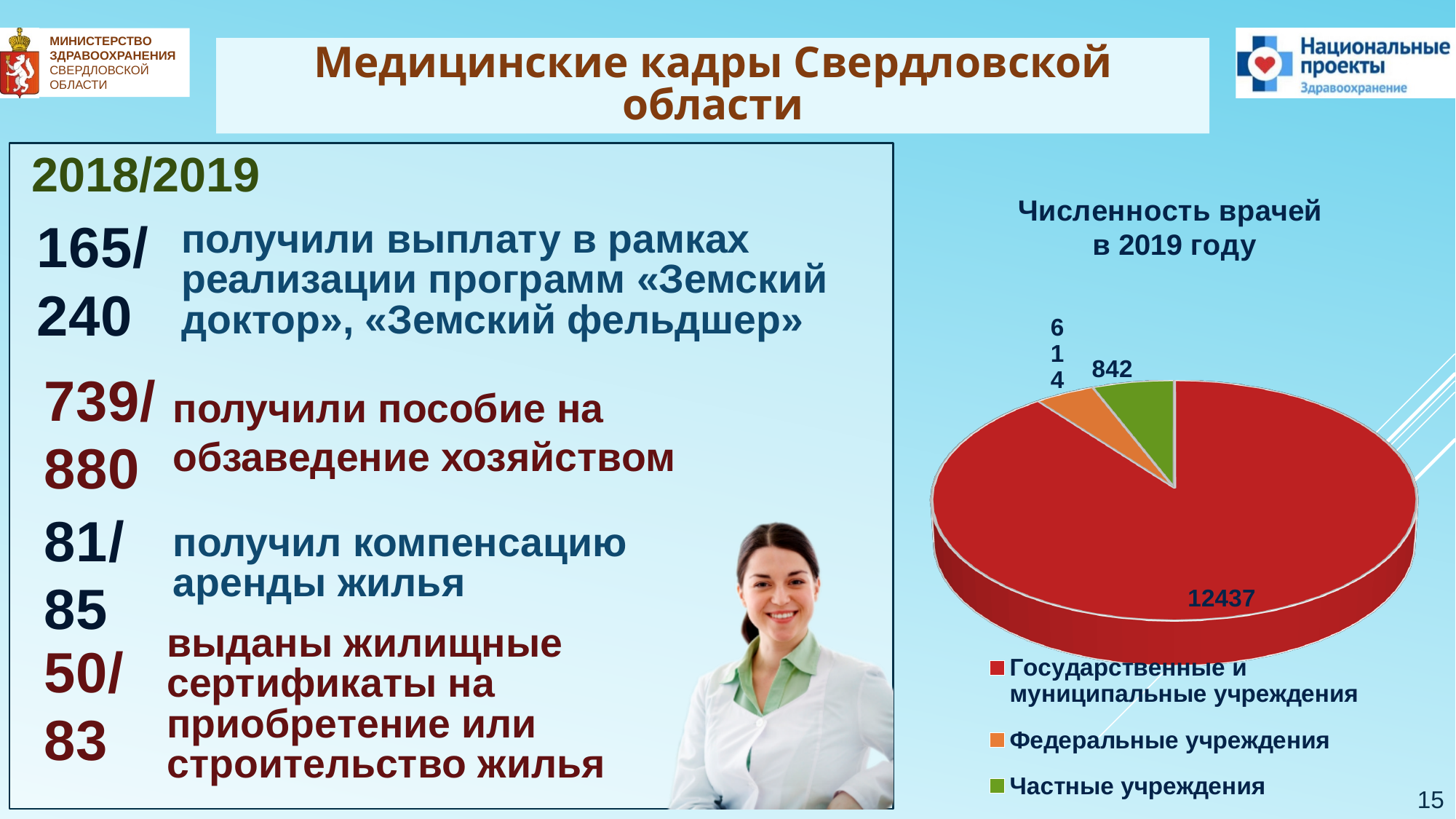
What type of chart is shown on the slide? pie chart How many slices does the pie chart have? 3 What is the title of the chart on the slide? Численность врачей в 2019 году Which is larger in the pie chart: Федеральные учреждения or Государственные и муниципальные учреждения? Государственные и муниципальные учреждения What is the total of all three values shown in the pie chart? 13893 How many entries does the legend of the pie chart list? 3 Which category has the largest slice in the pie chart? Государственные и муниципальные учреждения What is the value for Государственные и муниципальные учреждения in the pie chart? 12437 What colour is the slice for Государственные и муниципальные учреждения? red Which is larger in the pie chart: Государственные и муниципальные учреждения or Частные учреждения? Государственные и муниципальные учреждения